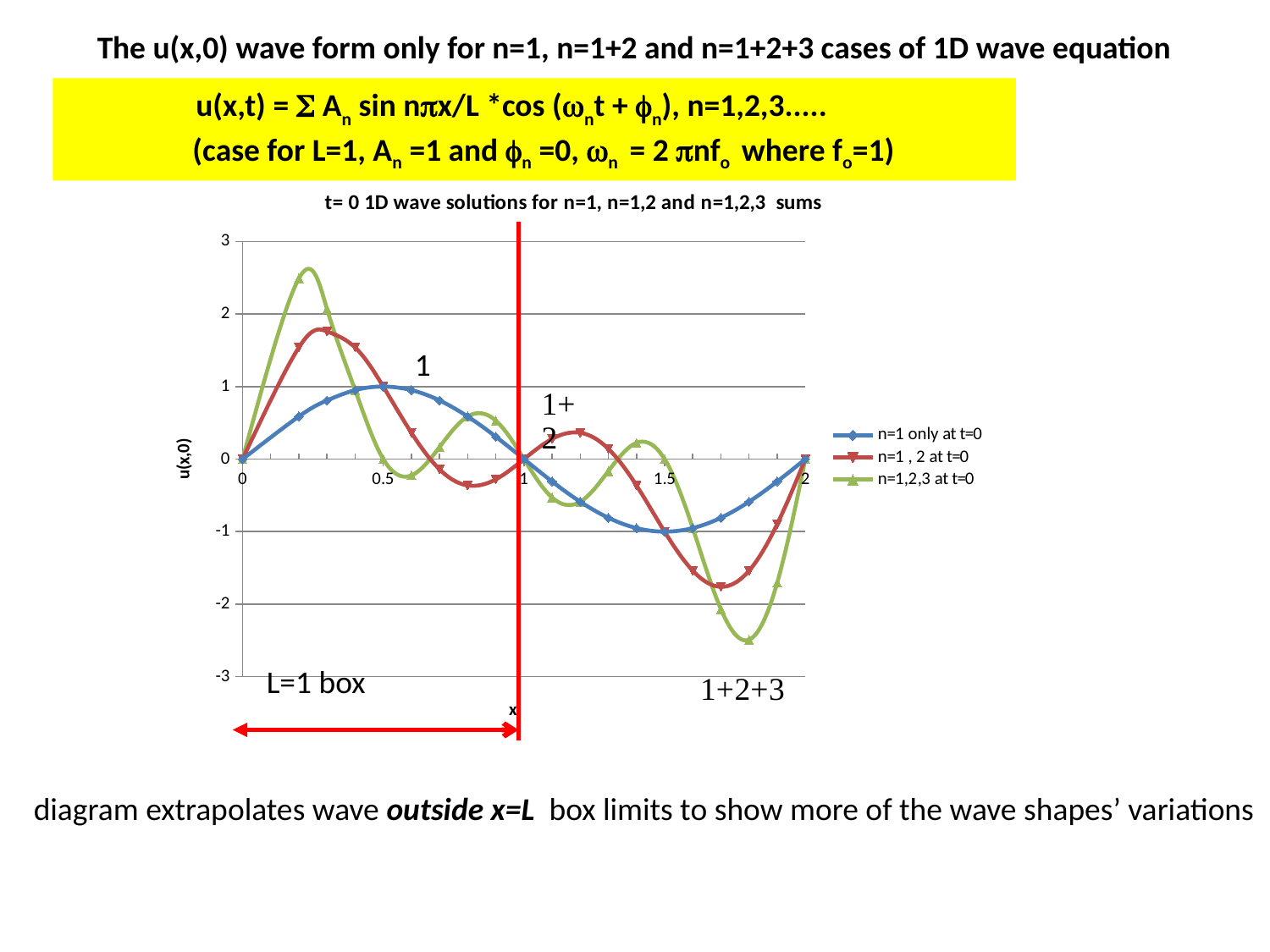
Is the peak value of the n=1 , 2 at t=0 series greater or less than 2? less What kind of chart is shown on the slide? line chart Does the n=1 only at t=0 series rise or fall as x goes from 0.5 to 1.5? fall Is the minimum value of the n=1,2,3 at t=0 series greater or less than -2? less Which series reaches the lowest value on the chart? n=1,2,3 at t=0 Which series has the higher peak, n=1 only at t=0 or n=1 , 2 at t=0? n=1 , 2 at t=0 Is the minimum value of the n=1 , 2 at t=0 series greater or less than -2? greater What is the title of the chart? t= 0 1D wave solutions for n=1, n=1,2 and n=1,2,3 sums What is the label on the vertical axis of the chart? u(x,0) How many series does the chart legend list? 3 Which series reaches the highest peak value on the chart? n=1,2,3 at t=0